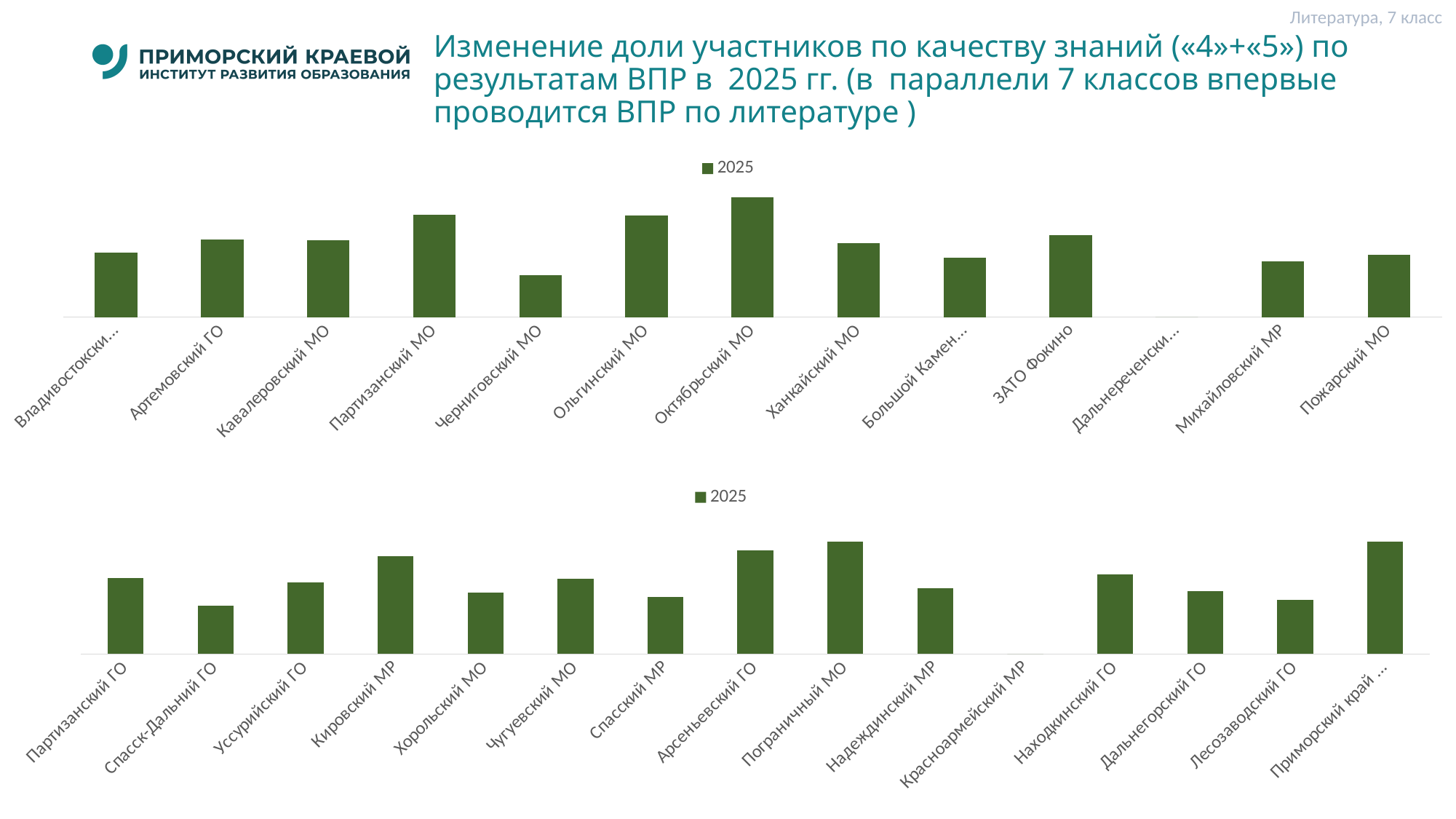
In the top chart, which category with a visible bar has the shortest bar? Черниговский МО What kind of chart is the top chart on the slide? bar chart In the top chart, which is larger: the value for Ольгинский МО or for Ханкайский МО? Ольгинский МО How many categories are shown on the x axis of the bottom chart? 15 In the top chart, which is larger: the value for Партизанский МО or for Черниговский МО? Партизанский МО In the top chart, which category has the tallest bar? Октябрьский МО In the top chart, which category has no visible bar at all? Дальнереченски... How many categories are shown on the x axis of the top chart? 13 In the bottom chart, which is larger: the value for Кировский МР or for Хорольский МО? Кировский МР How many series does the legend of the top chart list? 1 In the bottom chart, which category with a visible bar has the shortest bar? Спасск-Дальний ГО